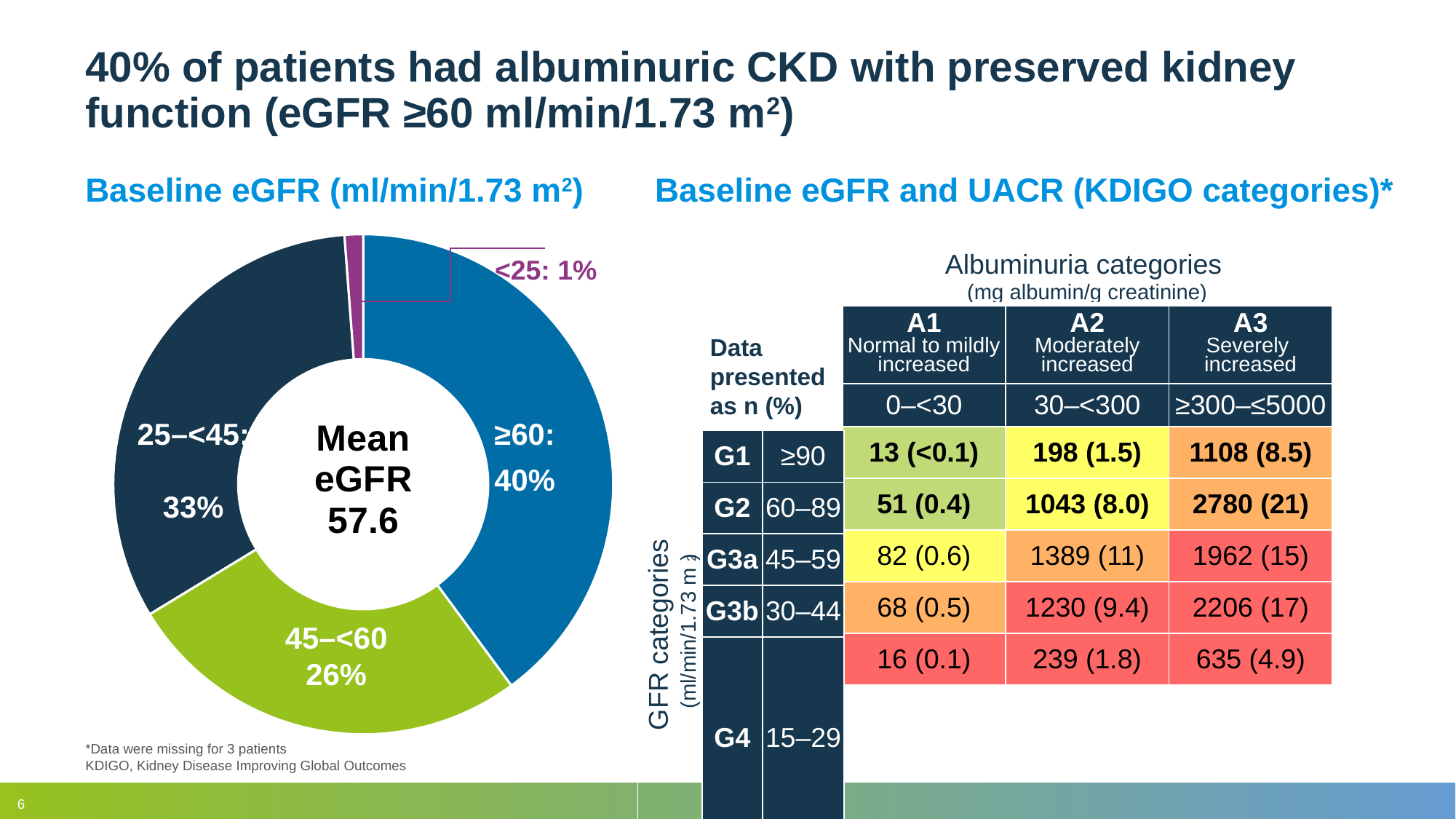
In the Baseline eGFR pie chart, what share of patients had an eGFR of <25? 1% In the Baseline eGFR pie chart, which eGFR category has the largest share? ≥60 In the Baseline eGFR pie chart, what share of patients had an eGFR of 25–<45? 33% In the Baseline eGFR pie chart, what is the difference in percentage points between the ≥60 and 45–<60 categories? 14 In the Baseline eGFR pie chart, which category has a larger share: 25–<45 or 45–<60? 25–<45 What kind of chart is shown under the heading 'Baseline eGFR (ml/min/1.73 m²)'? Pie chart (donut) In the Baseline eGFR pie chart, what share of patients had an eGFR of 45–<60? 26% In the Baseline eGFR pie chart, how many eGFR categories are shown? 4 In the Baseline eGFR pie chart, what colour is the slice for the ≥60 category? Blue What mean eGFR value is printed in the centre of the Baseline eGFR pie chart? 57.6 In the Baseline eGFR pie chart, which eGFR category has the smallest share? <25